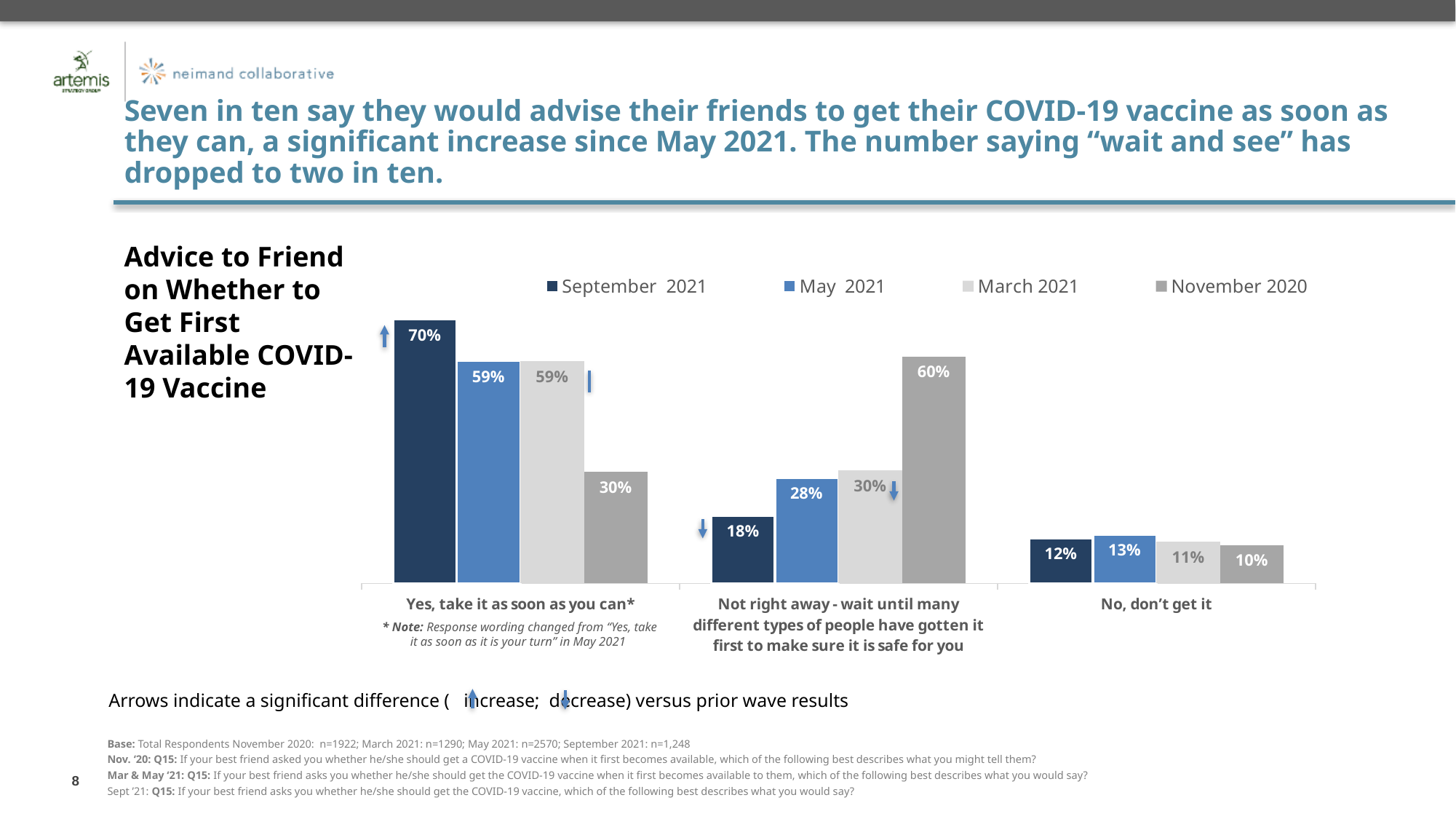
Which survey wave has the highest value for "Yes, take it as soon as you can*"? September 2021 What is the September 2021 value for "Yes, take it as soon as you can*"? 70% How many response categories are shown on the x axis? 3 What is the difference between the September 2021 and November 2020 values for "Yes, take it as soon as you can*"? 40 percentage points What is the difference between the May 2021 and September 2021 values for "Not right away - wait until many different types of people have gotten it first to make sure it is safe for you"? 10 percentage points What is the November 2020 value for "Not right away - wait until many different types of people have gotten it first to make sure it is safe for you"? 60% What is the title of the chart? Advice to Friend on Whether to Get First Available COVID-19 Vaccine What is the May 2021 value for "No, don't get it"? 13% How many series does the legend list? 4 Which is larger for "Not right away - wait until many different types of people have gotten it first to make sure it is safe for you": the March 2021 value or the September 2021 value? March 2021 What kind of chart is shown on the slide? Bar chart Which survey wave has the lowest value for "No, don't get it"? November 2020